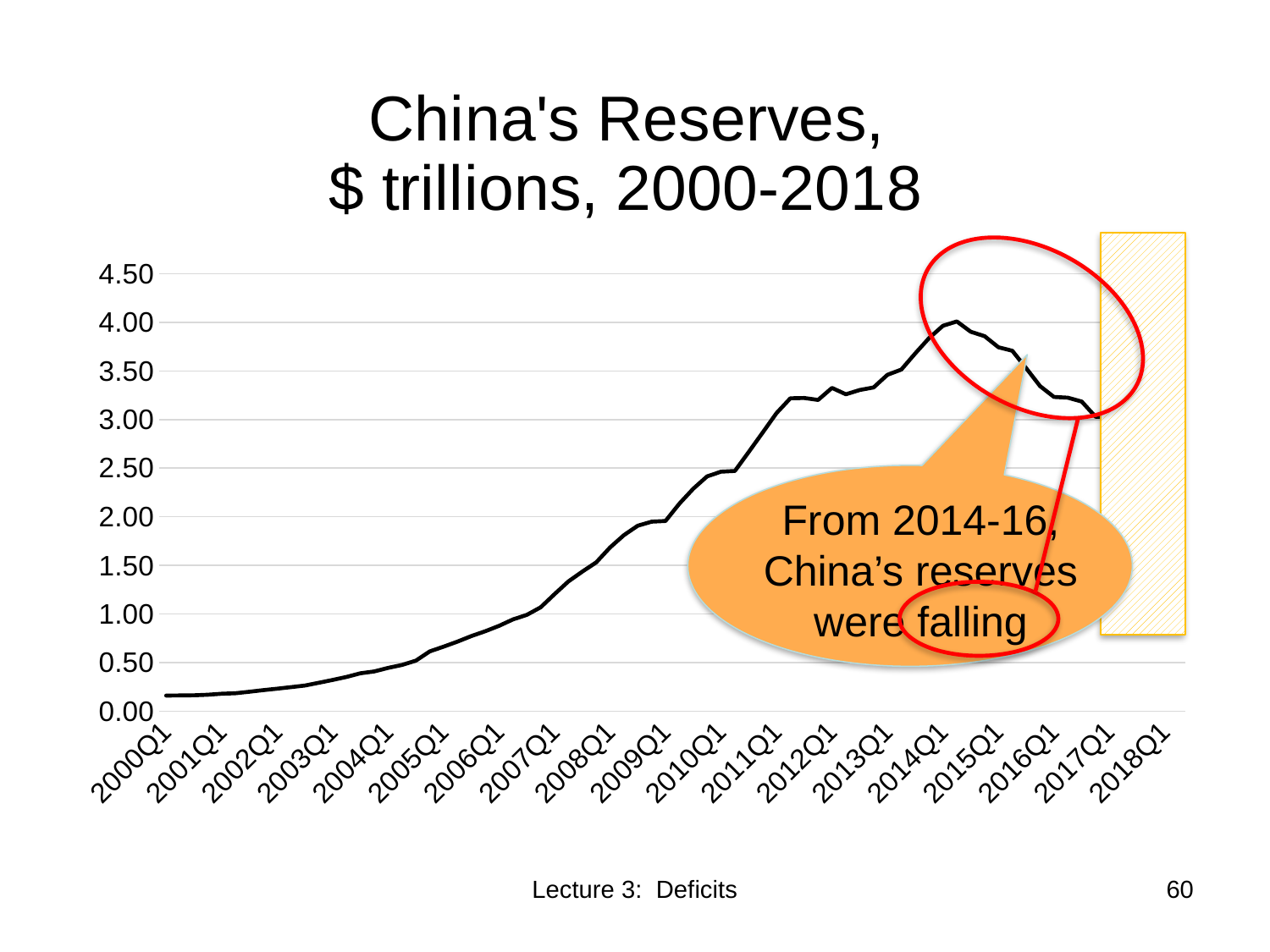
Do China's reserves rise or fall along the x axis from 2015Q1 to 2017Q1? fall Do China's reserves rise or fall along the x axis from 2000Q1 to 2014Q1? rise Is the value for 2015Q1 greater or less than 3.50? greater Is the value for 2000Q1 greater or less than 0.50? less Which x-axis label has the lowest value of China's reserves? 2000Q1 Is the value for 2016Q1 greater or less than 3.50? less What is the title of the chart? China's Reserves, $ trillions, 2000-2018 How many x-axis labels are shown on the chart? 19 What kind of chart is shown on the slide? line chart